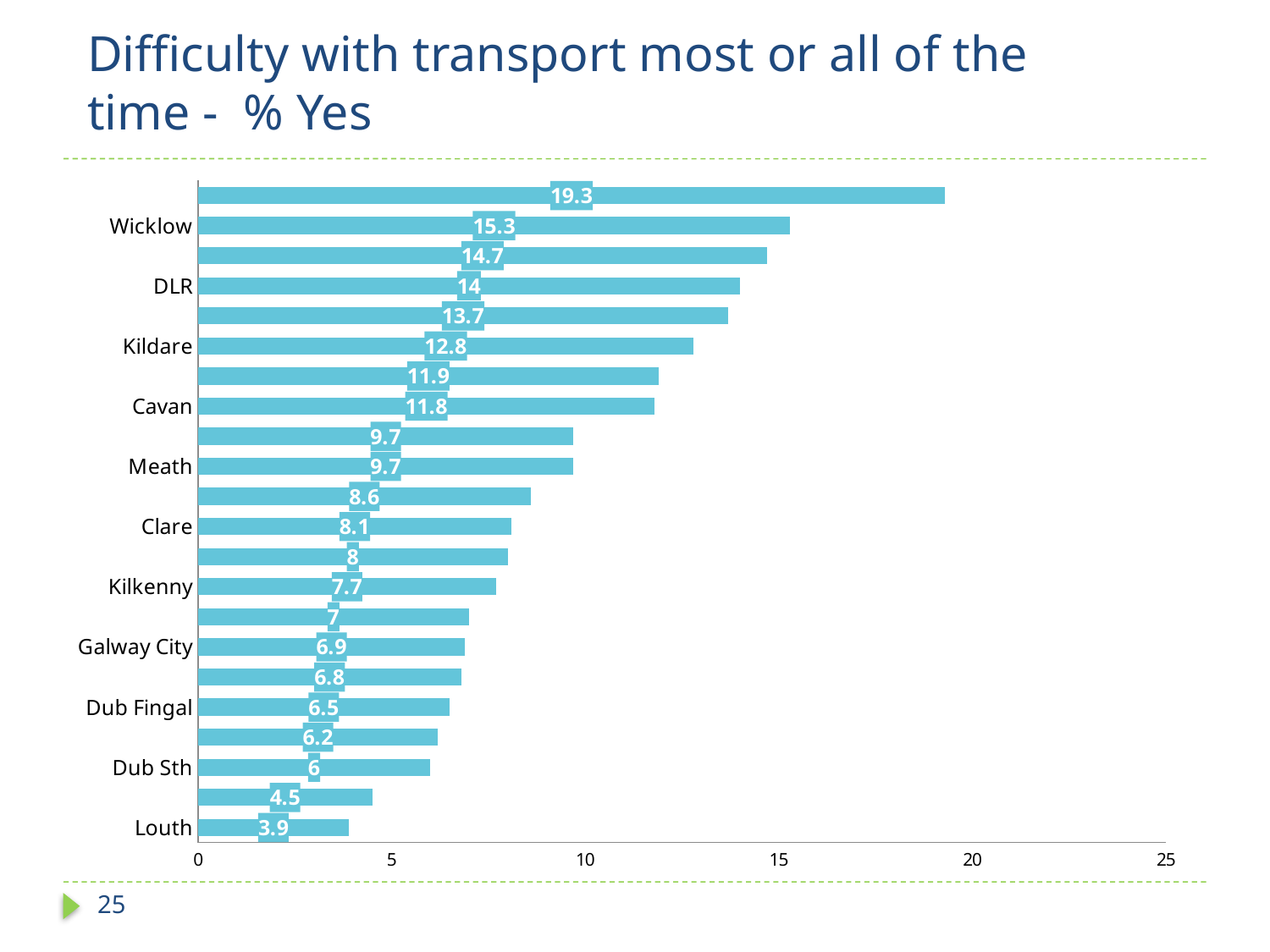
What is the value for Galway City? 6.9 What is the value for Kildare? 12.8 Do the bar values increase or decrease going from the top of the chart to the bottom? Decrease What is the highest value shown on the chart? 19.3 What is the difference between the values for Wicklow and DLR? 1.3 What is the value for Wicklow? 15.3 Which has a higher value, Cavan or Meath? Cavan What is the value for Dub Sth? 6 What kind of chart is shown on the slide? Bar chart What is the value for Louth? 3.9 Which labelled category has the lowest value? Louth How many bars are plotted on the chart? 22